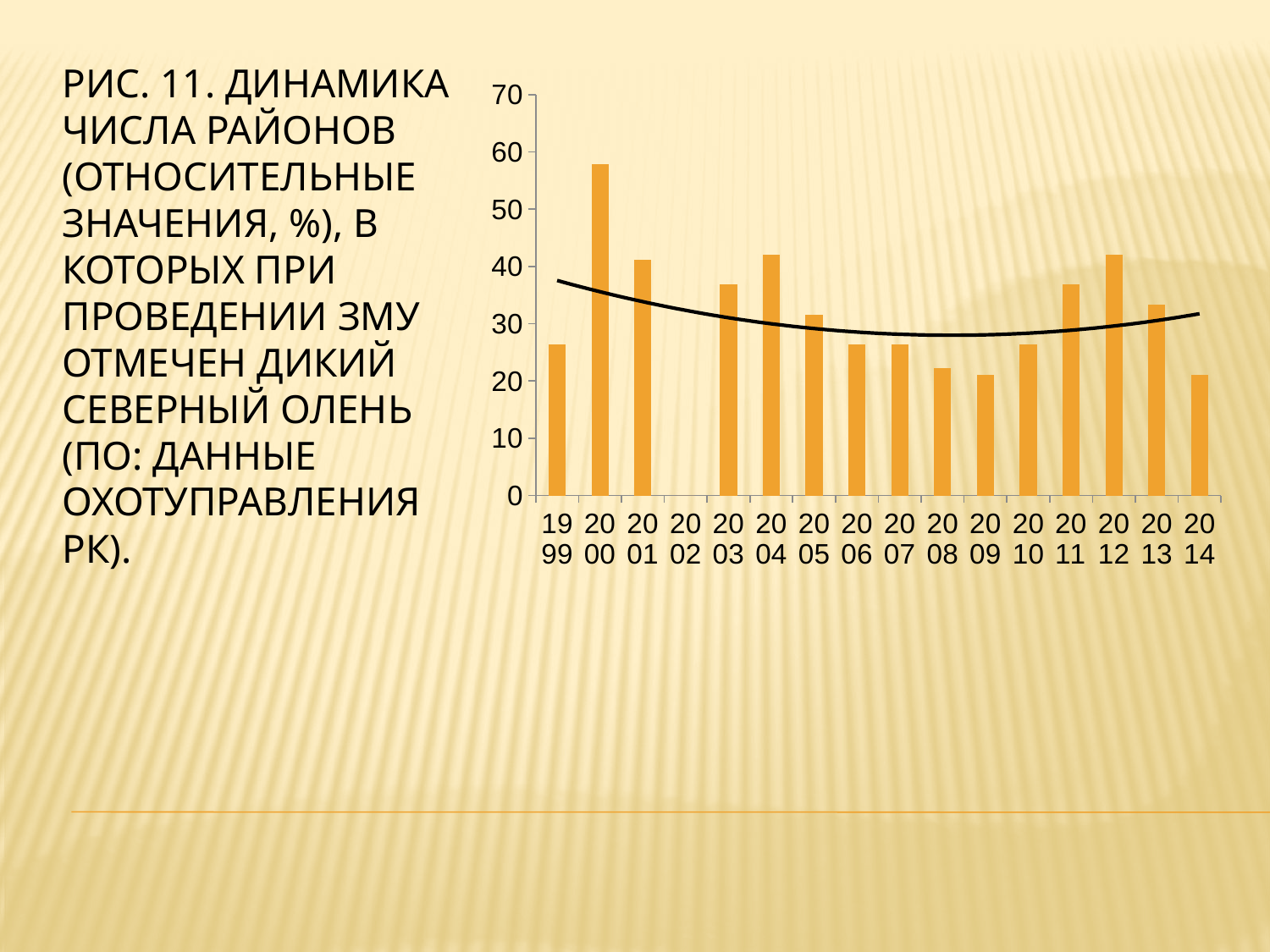
Which is larger, the value for 2008 or the value for 2011? 2011 How many years are listed along the x axis of the chart? 16 Which is larger, the value for 2000 or the value for 2001? 2000 Which year has the highest bar in the chart? 2000 What is the highest tick value shown on the y axis? 70 Which year on the x axis has no bar shown? 2002 What kind of chart is shown on the slide? bar chart Is the value for 2003 greater or less than 30? greater Is the value for 2009 greater or less than 30? less Is the value for 1999 greater or less than 30? less Which is larger, the value for 2004 or the value for 2005? 2004